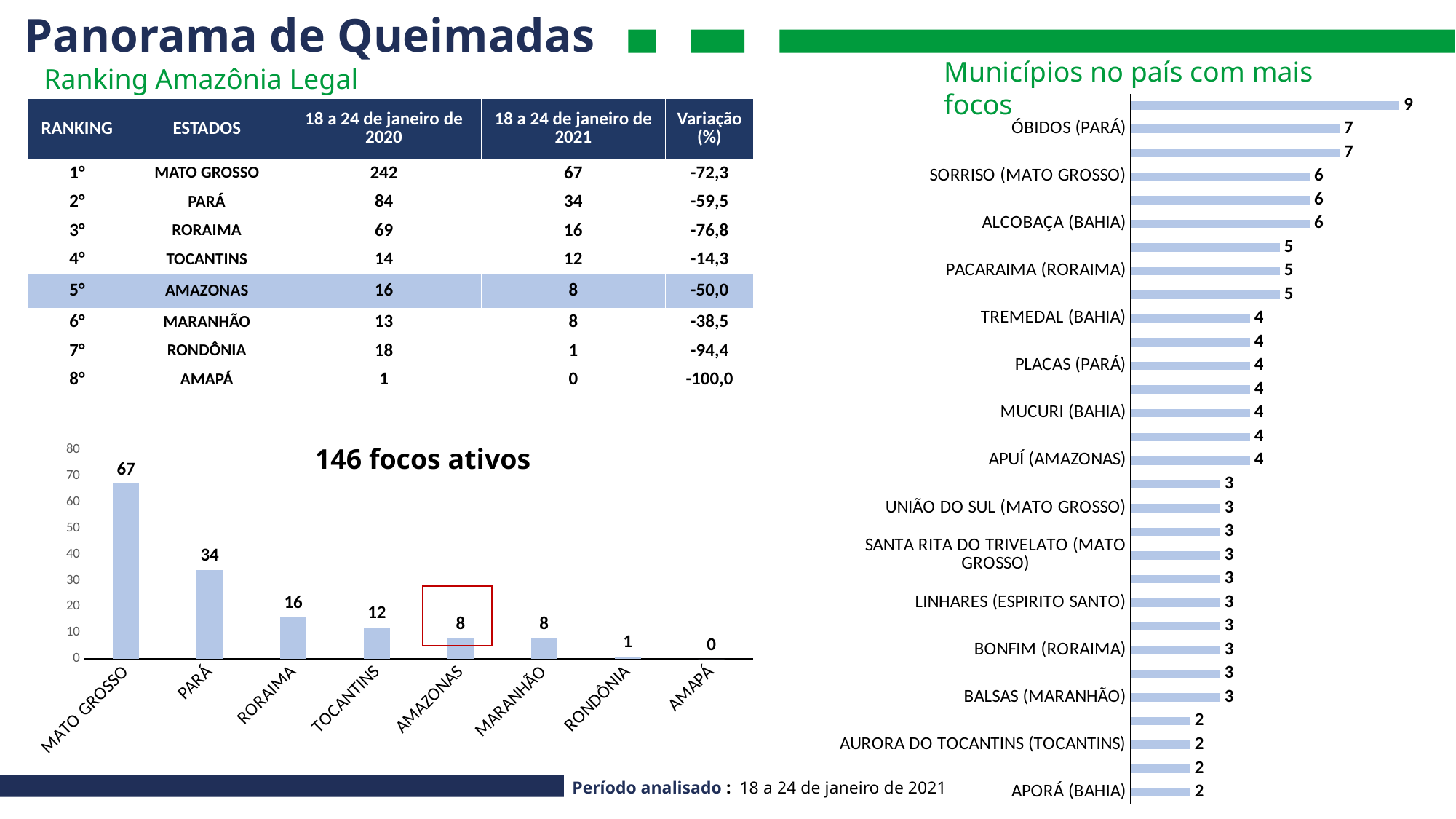
In the '146 focos ativos' chart, what is the difference between the values for MATO GROSSO and PARÁ? 33 In the '146 focos ativos' chart, which state has the highest value? MATO GROSSO In the 'Municípios no país com mais focos' chart, which is larger, the value for ÓBIDOS (PARÁ) or the value for BALSAS (MARANHÃO)? ÓBIDOS (PARÁ) In the '146 focos ativos' chart, what is the value for PARÁ? 34 In the '146 focos ativos' chart, which state has the lowest value? AMAPÁ How many states are shown in the '146 focos ativos' chart? 8 In the '146 focos ativos' chart, what is the value for TOCANTINS? 12 What kind of chart is the '146 focos ativos' chart? bar chart In the 'Municípios no país com mais focos' chart, what is the value for APUÍ (AMAZONAS)? 4 In the '146 focos ativos' chart, do the values rise or fall from left to right along the x axis? fall In the '146 focos ativos' chart, which is larger, the value for RORAIMA or the value for MARANHÃO? RORAIMA In the 'Municípios no país com mais focos' chart, what is the value for SORRISO (MATO GROSSO)? 6